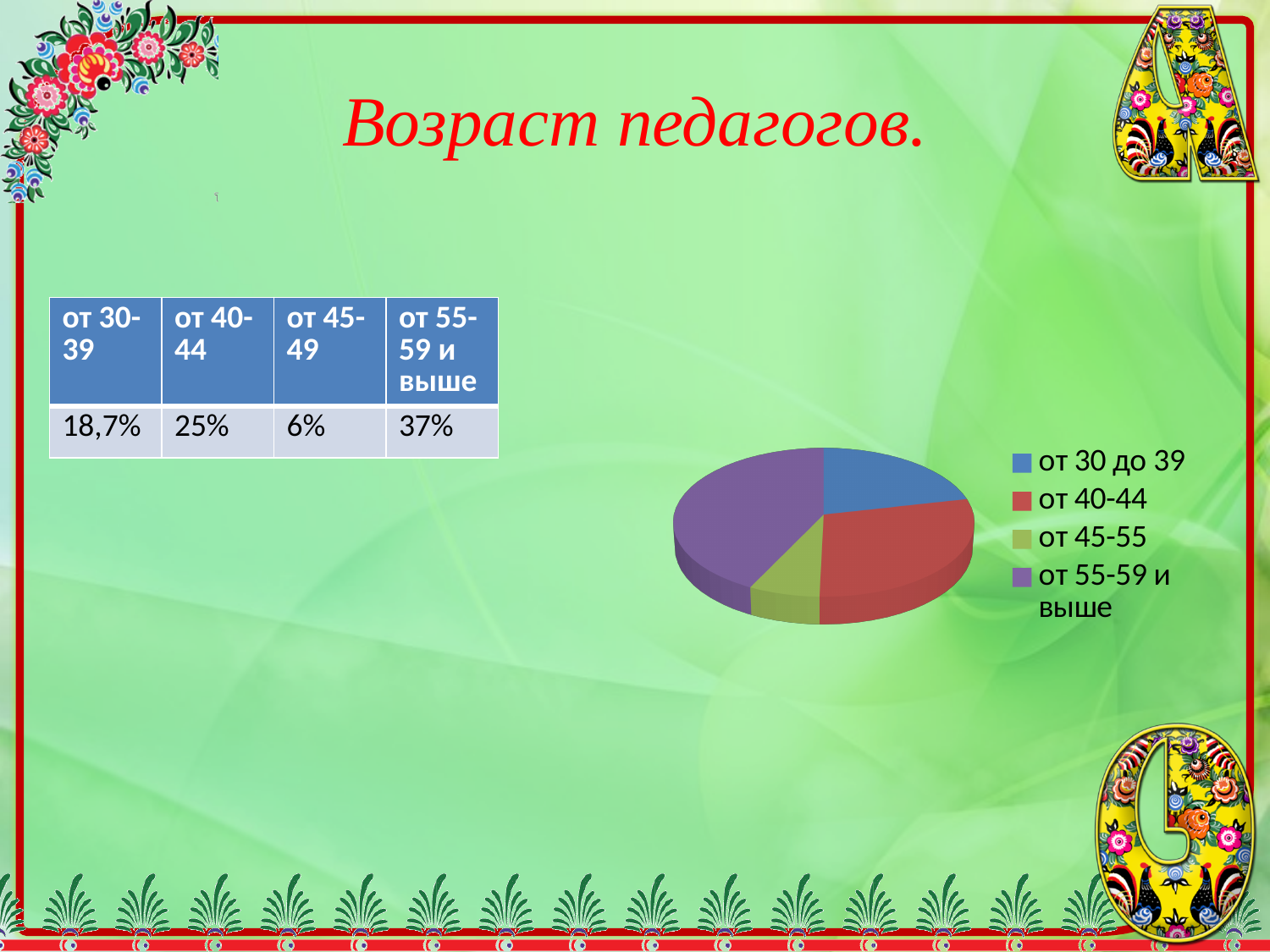
Which age group has the largest slice in the pie chart? от 55-59 и выше According to the table on the slide, what share of teachers are aged от 55-59 и выше? 37% According to the table on the slide, what share of teachers are aged от 30-39? 18,7% What kind of chart is shown on the slide? pie chart Which slice is larger in the pie chart: от 40-44 or от 55-59 и выше? от 55-59 и выше What colour is the slice for от 55-59 и выше in the pie chart? purple Which slice is larger in the pie chart: от 30 до 39 or от 40-44? от 40-44 How many entries does the legend of the pie chart list? 4 According to the table on the slide, what share of teachers are aged от 40-44? 25% What is the title of the slide containing the pie chart? Возраст педагогов. How many slices does the pie chart have? 4 Which age group has the smallest slice in the pie chart? от 45-55